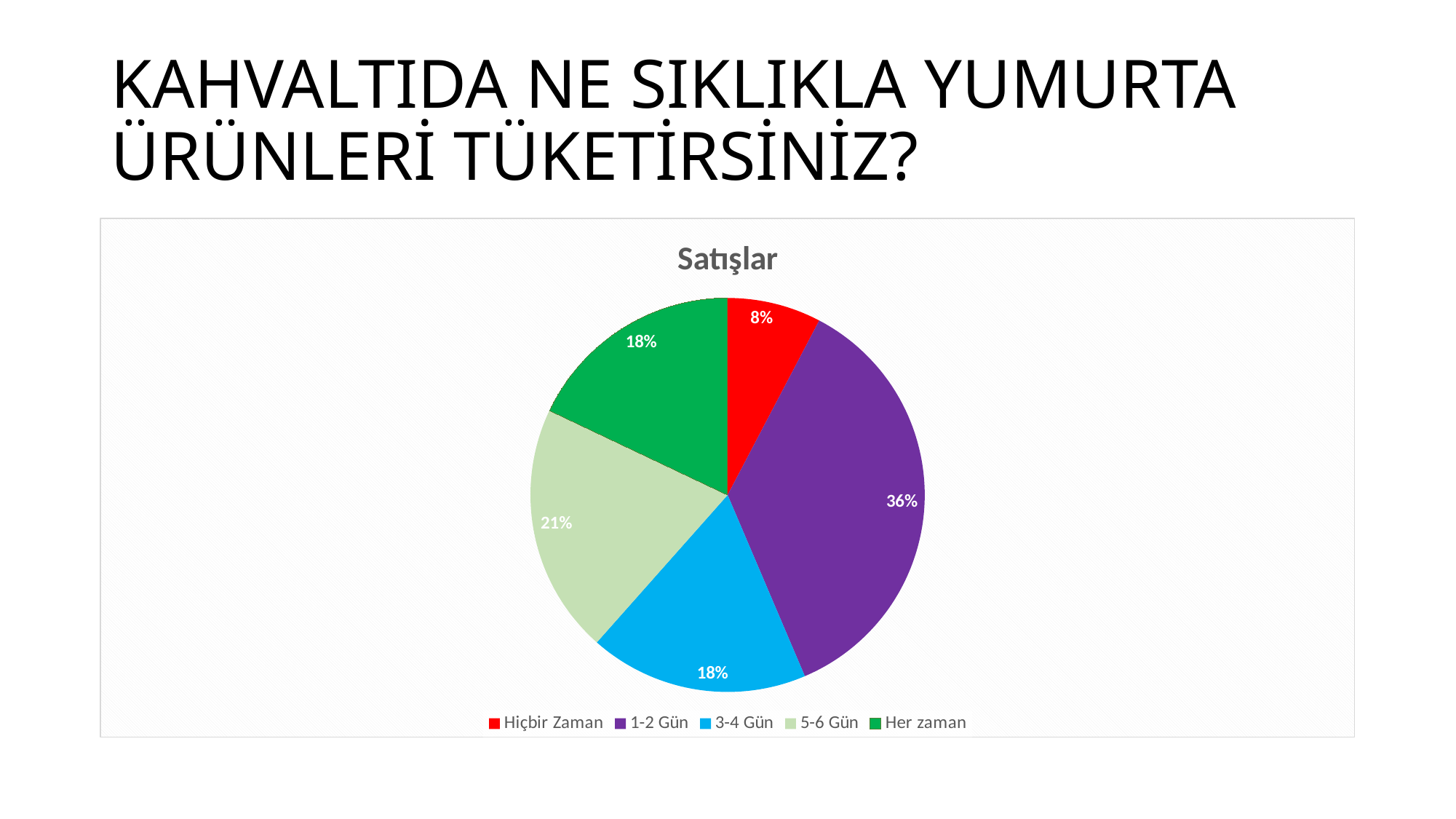
Which category has the largest slice of the pie? 1-2 Gün What share of the pie does the 5-6 Gün slice represent? 21% What type of chart is shown on the slide? pie chart Which category has the smallest slice of the pie? Hiçbir Zaman What is the difference in percentage points between the 1-2 Gün slice and the 5-6 Gün slice? 15% What share of the pie does the Hiçbir Zaman slice represent? 8% Which is larger, the 5-6 Gün slice or the 3-4 Gün slice? 5-6 Gün What share of the pie does the 1-2 Gün slice represent? 36% What colour is the 3-4 Gün slice? blue What is the title of the chart? Satışlar How many categories does the pie chart have? 5